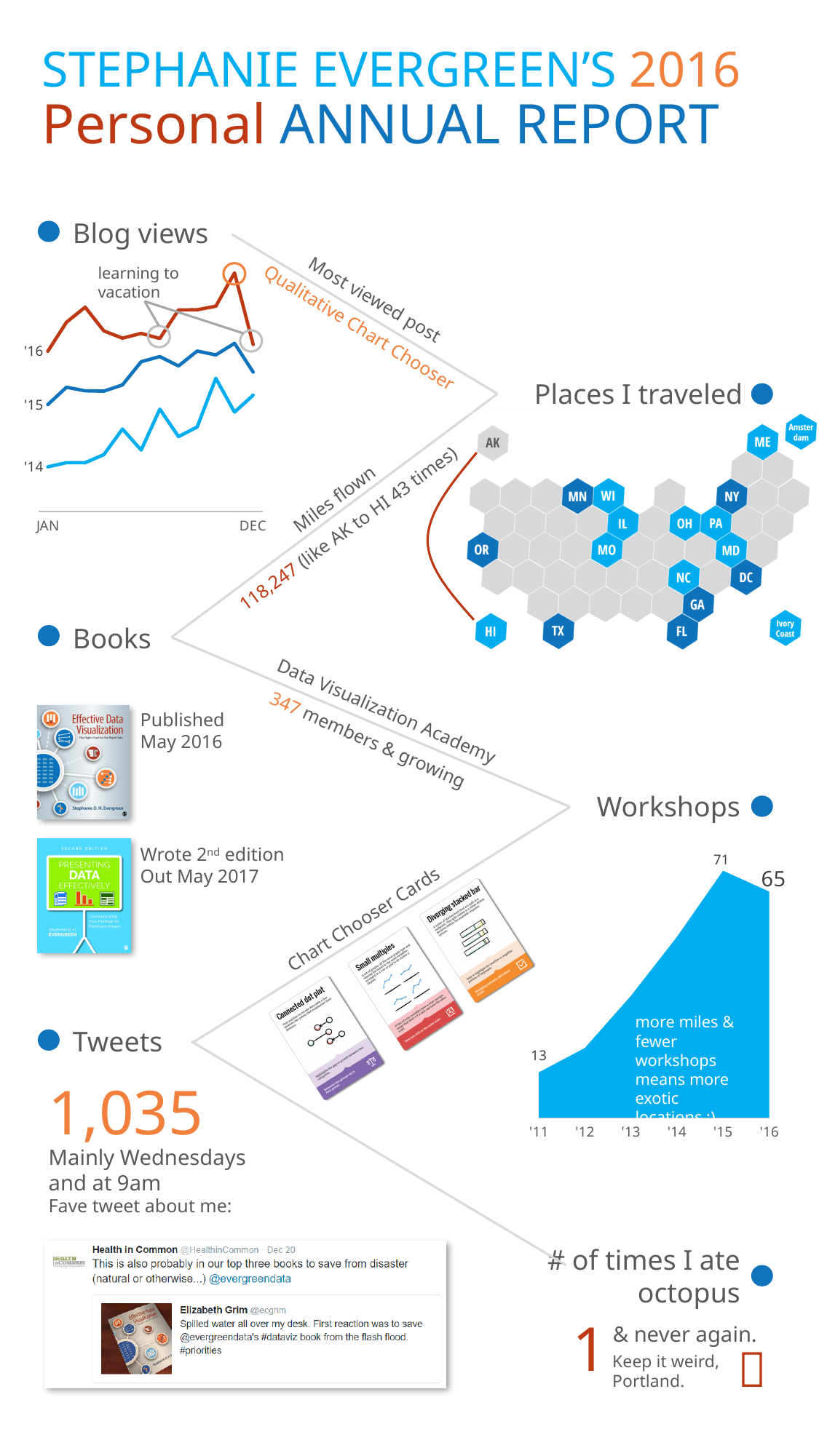
On the Blog views chart, how many year lines are plotted? 3 What kind of chart is the Blog views chart? line chart On the Workshops chart, what is the difference between the values for '15 and '11? 58 On the Workshops chart, how many years are shown on the x axis? 6 On the Workshops chart, what is the difference between the values for '15 and '16? 6 On the Workshops chart, which year has the highest value? '15 On the Workshops chart, what is the value for '11? 13 On the Workshops chart, what is the value for '16? 65 On the Workshops chart, do the values rise or fall from '11 to '15? rise On the Workshops chart, which year has the lowest value? '11 On the Blog views chart, which year's line is the lowest? '14 On the Workshops chart, what is the value for '15? 71